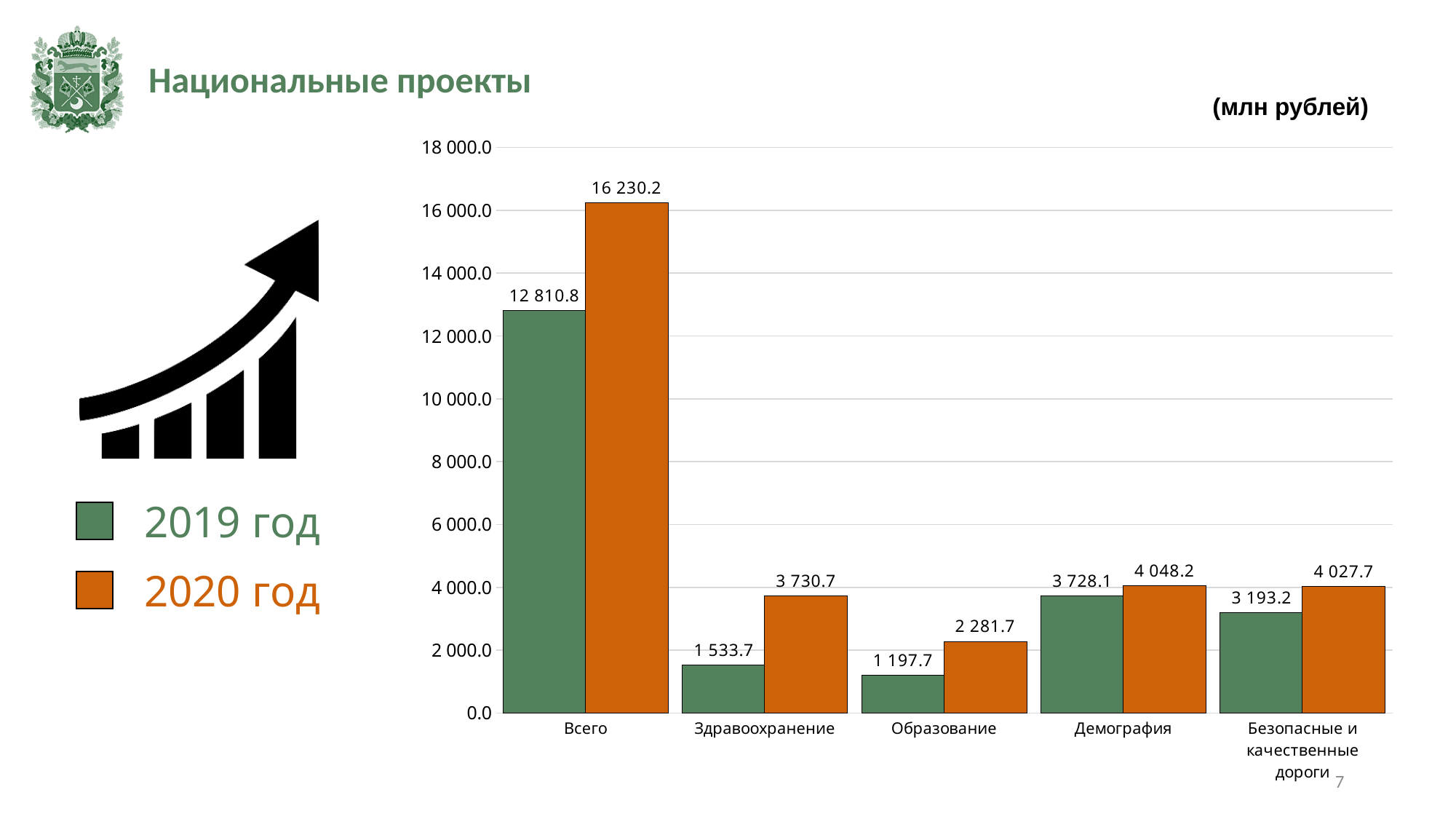
What is the 2020 value for Всего? 16 230.2 How many series does the legend list? 2 What is the difference between the 2020 and 2019 values for Здравоохранение? 2 197.0 Is the 2020 value for Образование greater or less than 2 000.0? greater Which category has the lowest 2019 value? Образование What is the 2019 value for Здравоохранение? 1 533.7 How many categories are shown on the x axis? 5 What is the difference between the 2020 and 2019 values for Всего? 3 419.4 What is the 2019 value for Безопасные и качественные дороги? 3 193.2 Which category has the highest 2020 value? Всего Which is larger, the 2019 value for Здравоохранение or the 2019 value for Образование? Здравоохранение What is the 2020 value for Образование? 2 281.7